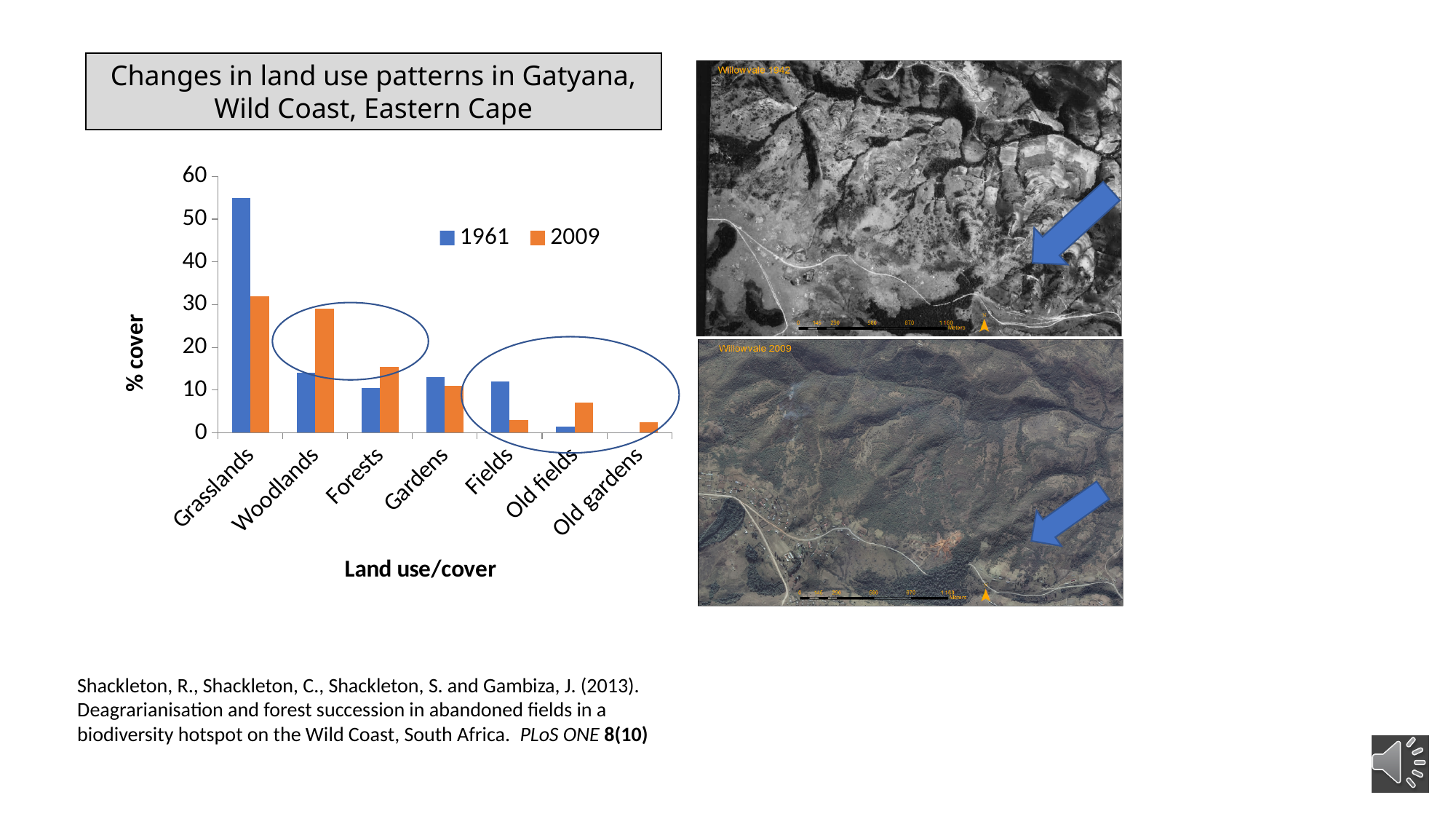
What kind of chart is shown on the slide? bar chart Which category has the highest % cover for 1961? Grasslands How many series does the chart's legend list? 2 How many land use/cover categories are shown on the x axis of the chart? 7 For Woodlands, which year has the larger % cover, 1961 or 2009? 2009 Is the 1961 value for Grasslands greater or less than 50? greater Which category has the highest % cover for 2009? Grasslands For Fields, which year has the larger % cover, 1961 or 2009? 1961 Which category has the lowest % cover for 2009? Old gardens Is the 2009 value for Fields greater or less than 10? less Is the 2009 value for Woodlands greater or less than 20? greater What is the title of the chart's y axis? % cover